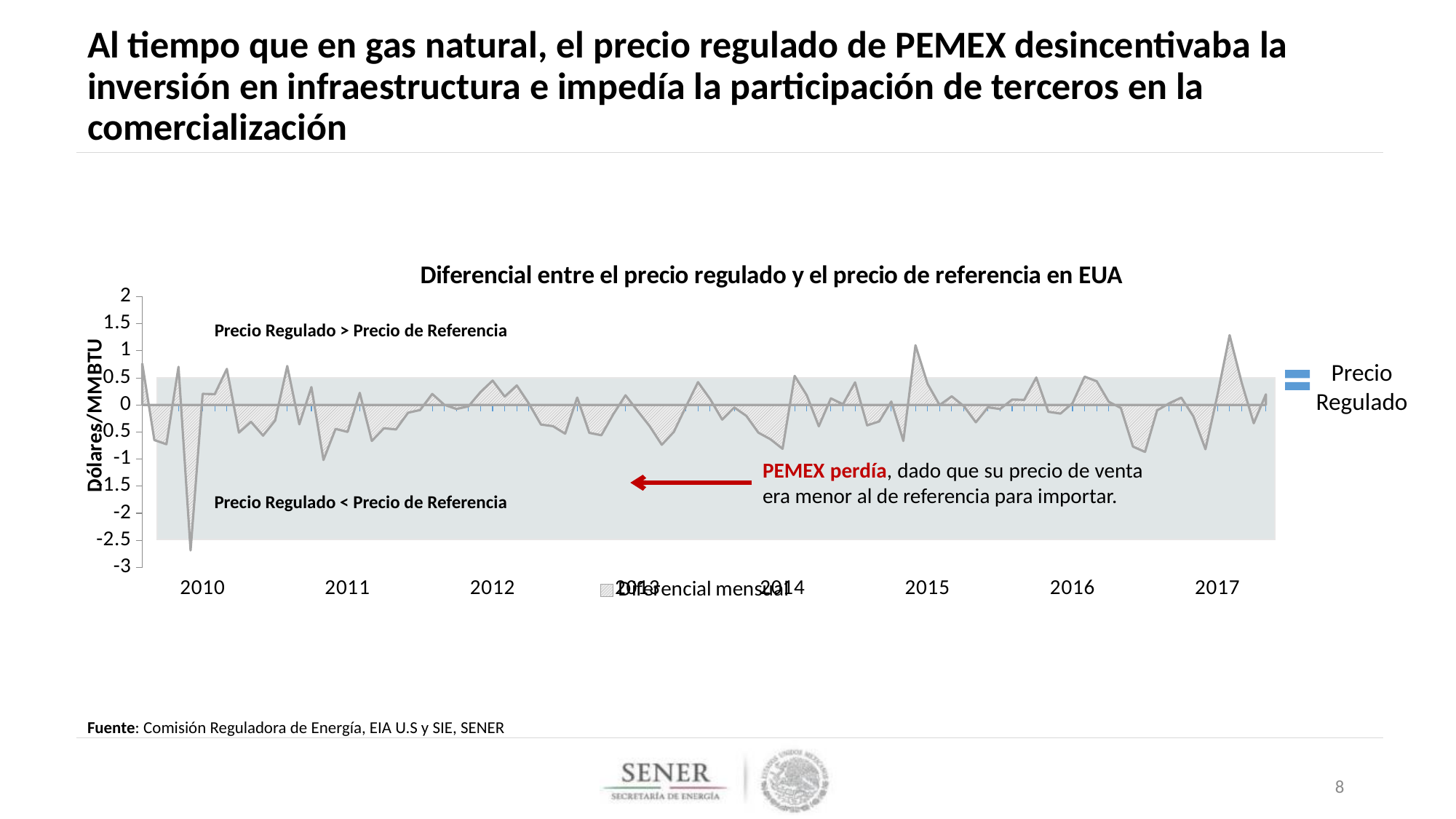
What is the title of the chart? Diferencial entre el precio regulado y el precio de referencia en EUA What is the highest value shown on the vertical axis of the chart? 2 Is the lowest value of the monthly differential during 2011 greater or less than -1.5? greater What kind of chart is used to show the monthly differential? area chart What is the lowest value shown on the vertical axis of the chart? -3 Which is larger: the peak of the monthly differential in 2017 or the peak in 2012? 2017 How many year labels are shown along the x axis of the chart? 8 Is the lowest value of the monthly differential, in 2010, greater or less than -2? less Is the peak value of the monthly differential at the start of 2015 greater or less than 0.5? greater